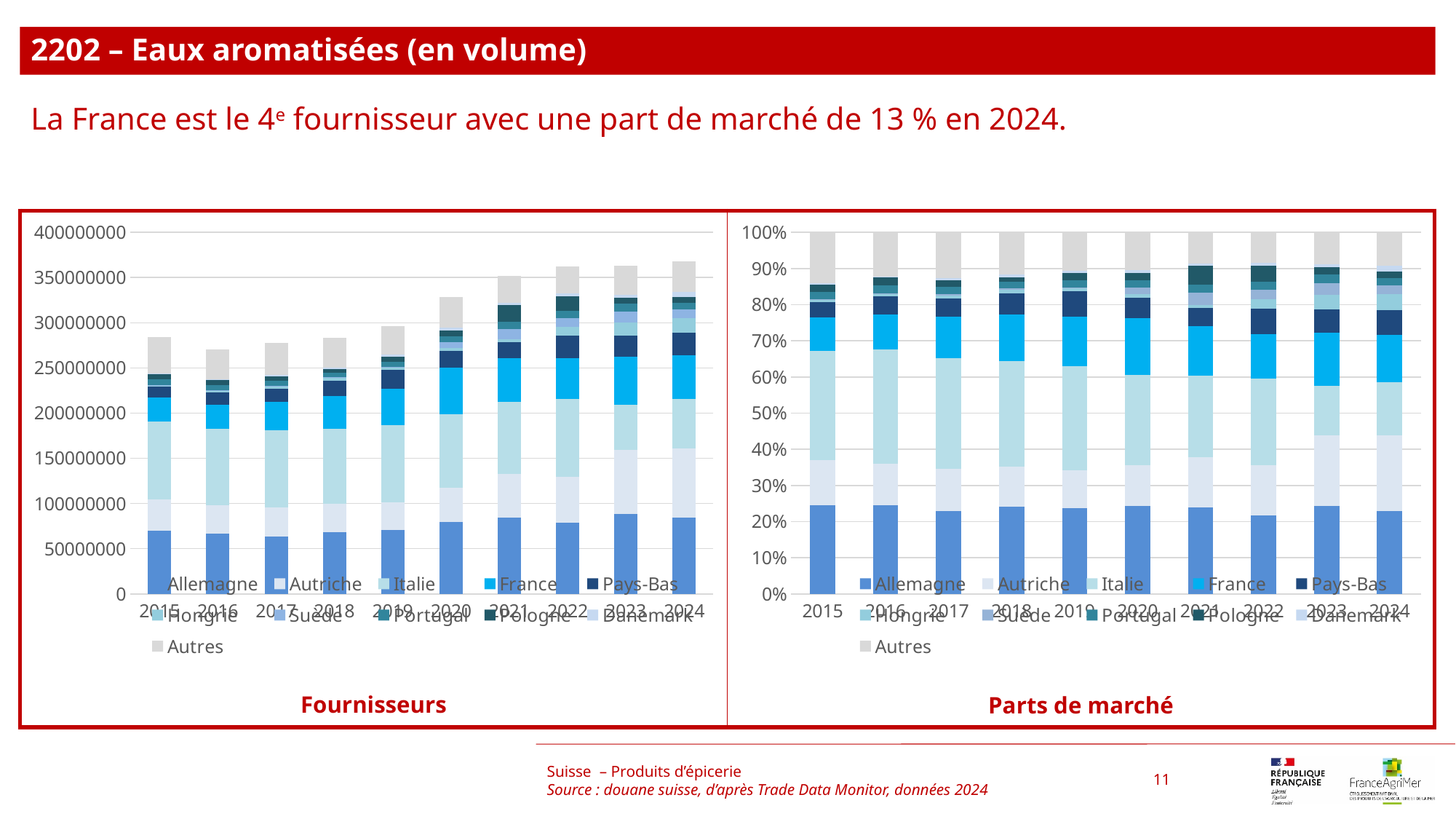
In the 'Parts de marché' chart, is the share of Allemagne in 2015 greater or less than 20%? greater In the 'Fournisseurs' chart, do the total volumes generally rise or fall from 2015 to 2024? rise In the 'Fournisseurs' chart, is the total for 2024 larger or smaller than the total for 2016? larger In the 'Fournisseurs' chart, which year has the lowest total stacked bar? 2016 In the 'Fournisseurs' chart, which year has the highest total stacked bar? 2024 In the 'Fournisseurs' chart, is the total for 2020 greater or less than 300000000? greater In the 'Fournisseurs' chart, is the total for 2024 greater or less than 350000000? greater What is the title of the chart on the right side of the slide? Parts de marché How many series does the legend of the 'Parts de marché' chart list? 11 How many years are shown on the x axis of the 'Fournisseurs' chart? 10 What kind of chart is the 'Fournisseurs' chart on the left? Stacked bar chart